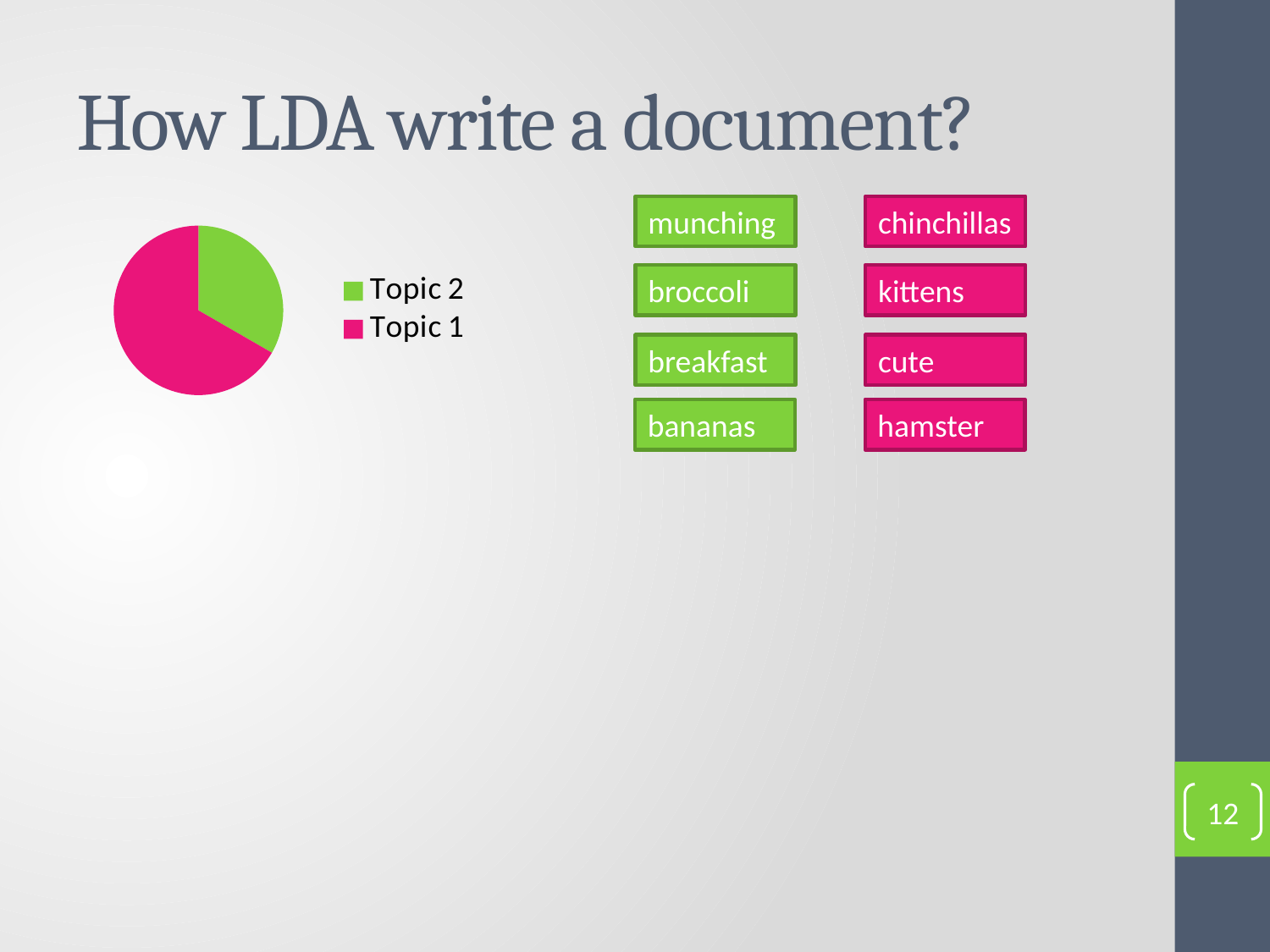
Which topic has the largest slice in the pie chart? Topic 1 How many entries does the legend of the pie chart list? 2 What colour represents Topic 1 in the pie chart? pink What kind of chart is shown on the slide? pie chart What colour represents Topic 2 in the pie chart? green Which topic has the smallest slice in the pie chart? Topic 2 How many slices does the pie chart have? 2 Which slice is larger in the pie chart, Topic 1 or Topic 2? Topic 1